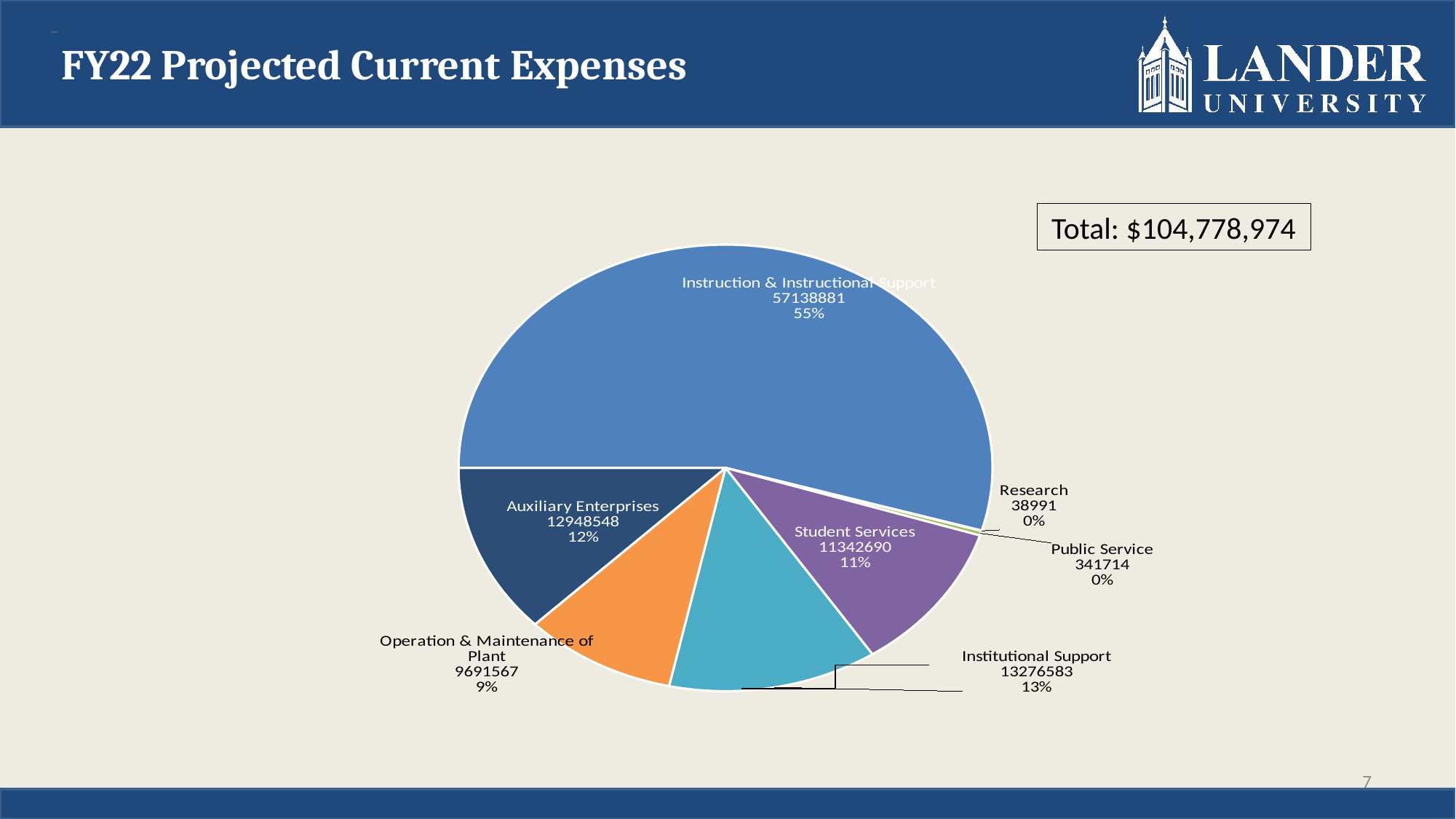
How many categories are shown in the pie chart? 7 Which category has the largest slice? Instruction & Instructional Support What is the difference between Institutional Support and Auxiliary Enterprises? 328035 What is the value for Institutional Support? 13276583 Which is larger, Student Services or Operation & Maintenance of Plant? Student Services What share of the pie does Student Services represent? 11% Which category has the smallest slice? Research What is the value for Instruction & Instructional Support? 57138881 What is the value for Research? 38991 What kind of chart is shown on the slide? pie chart What is the value for Auxiliary Enterprises? 12948548 What share of the pie does Operation & Maintenance of Plant represent? 9%